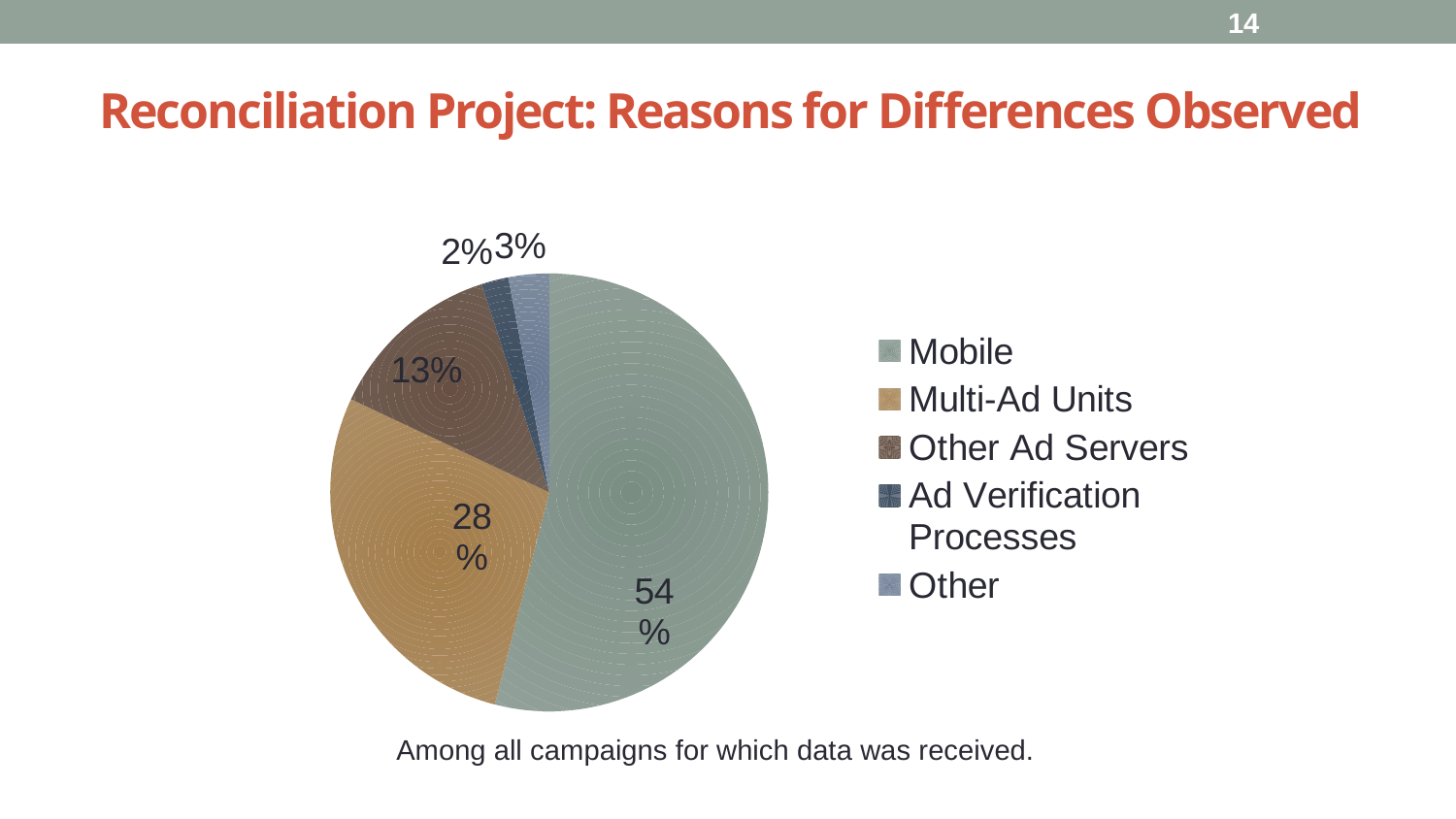
What share of the pie does Mobile account for? 54% What percentage is shown for Ad Verification Processes? 2% What is the difference in percentage points between Mobile and Multi-Ad Units? 26 Which category has the smallest slice of the pie? Ad Verification Processes What is the title of the slide containing the pie chart? Reconciliation Project: Reasons for Differences Observed What percentage is shown for the Other category? 3% What percentage is shown for Other Ad Servers? 13% Which is larger, the share for Other Ad Servers or the share for Other? Other Ad Servers How many categories does the legend list? 5 What kind of chart is shown on the slide? Pie chart What percentage is shown for Multi-Ad Units? 28% Which category has the largest slice of the pie? Mobile